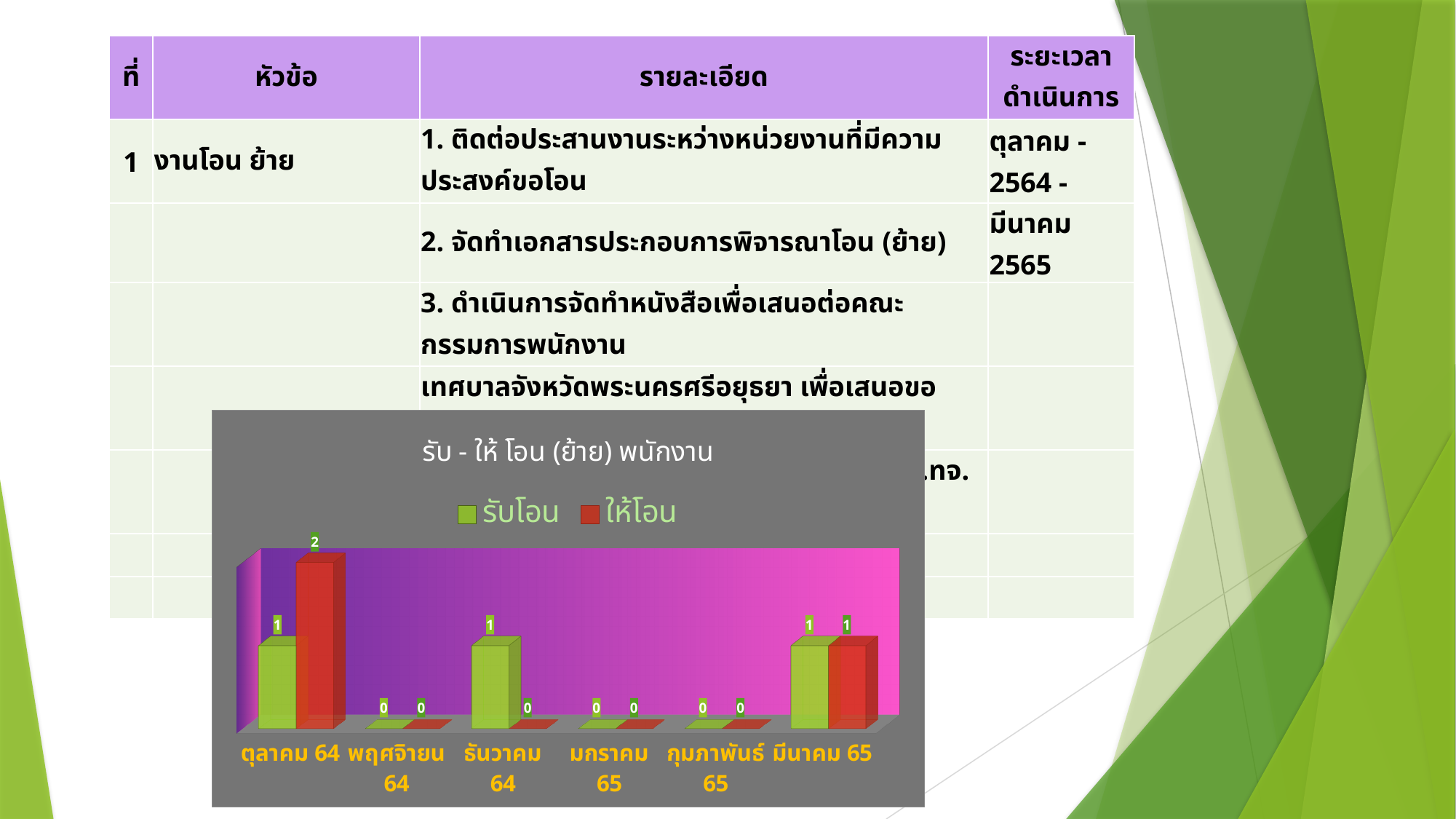
What is the value of ให้โอน for ธันวาคม 64? 0 How many series does the chart legend list? 2 In ธันวาคม 64, which is larger, รับโอน or ให้โอน? รับโอน What is the value of รับโอน for ตุลาคม 64? 1 How many months are shown on the x axis of the chart? 6 Which month has the highest value for ให้โอน? ตุลาคม 64 Which colour represents ให้โอน in the chart? Red What is the title of the chart? รับ - ให้ โอน (ย้าย) พนักงาน What is the value of รับโอน for มีนาคม 65? 1 What is the value of ให้โอน for ตุลาคม 64? 2 What is the difference between ให้โอน and รับโอน in ตุลาคม 64? 1 What kind of chart is shown on the slide? Bar chart